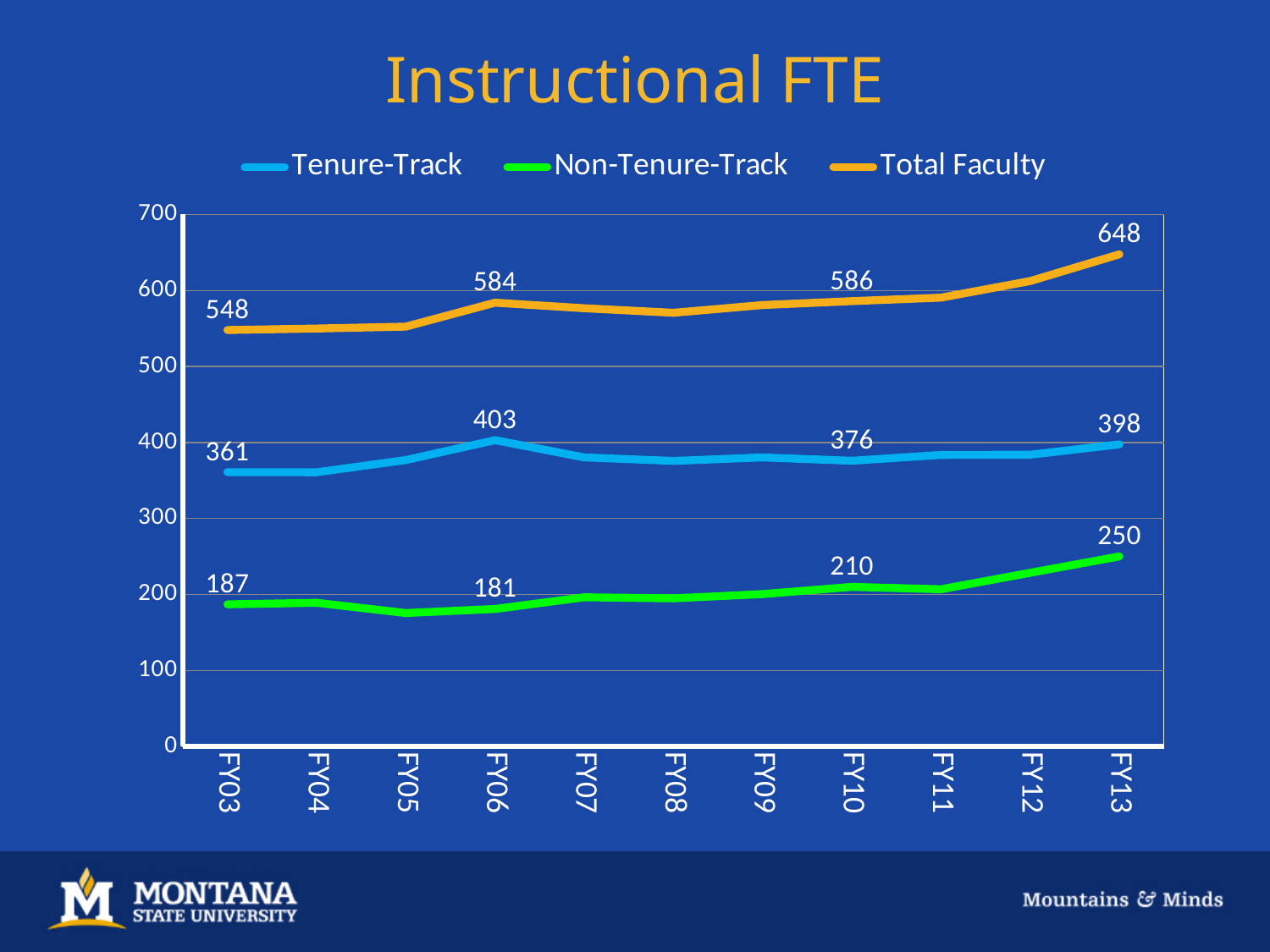
What is the Total Faculty value in FY13? 648 What is the Non-Tenure-Track value in FY03? 187 What is the Total Faculty value in FY10? 586 What kind of chart is shown on the slide? line chart Is the Tenure-Track value for FY08 greater or less than 400? less How many fiscal years are shown on the x axis? 11 How many series does the legend list? 3 Which is larger for Tenure-Track: the FY06 value or the FY13 value? FY06 By how much did Total Faculty increase from FY03 to FY13? 100 What is the Tenure-Track value in FY06? 403 What is the difference between the Non-Tenure-Track values in FY13 and FY10? 40 Does the Total Faculty line rise or fall from FY10 to FY13? rise